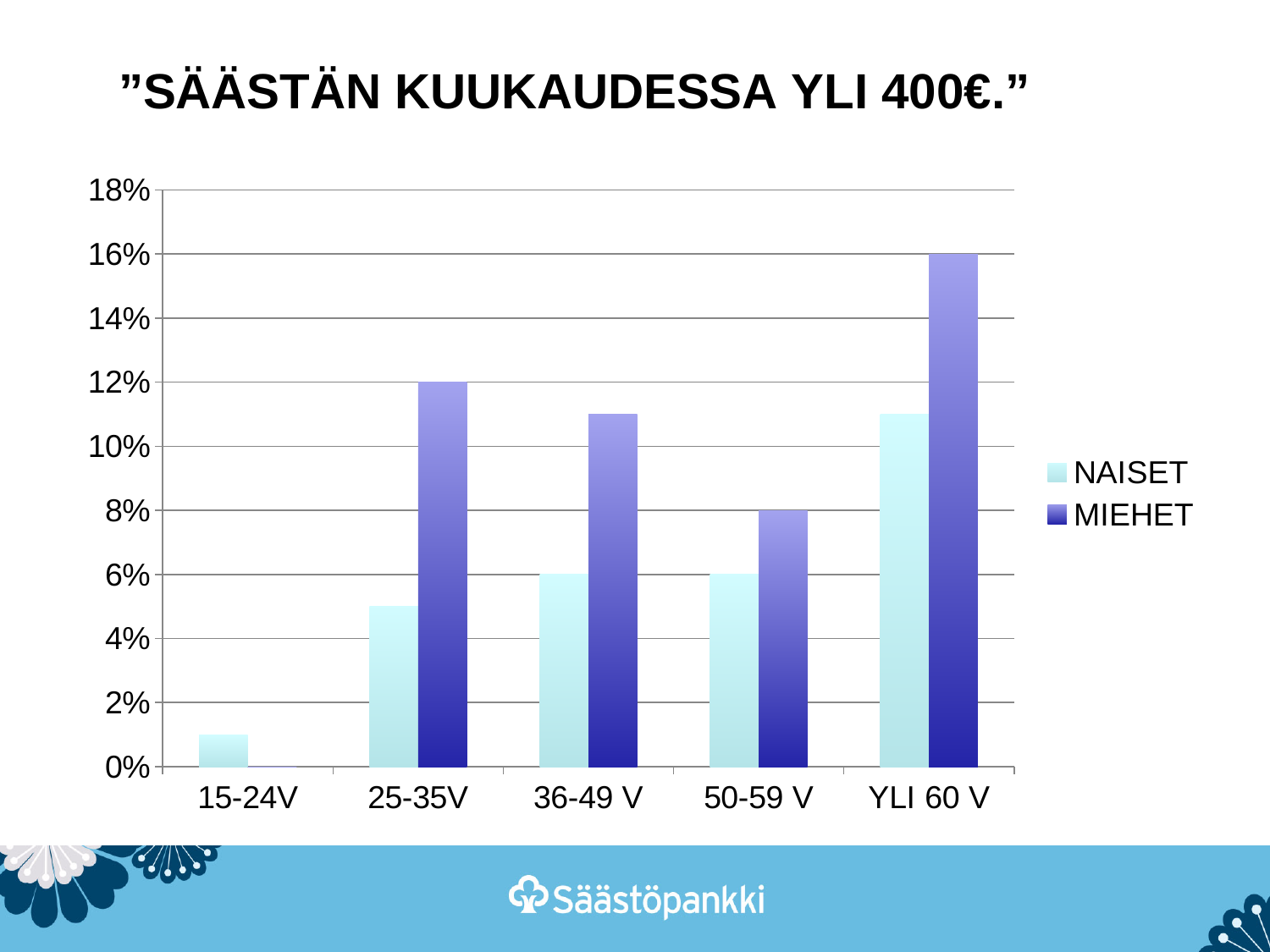
What is the difference between the MIEHET values for YLI 60 V and 25-35V? 4% Which age category has the highest MIEHET value? YLI 60 V What is the value for MIEHET in the YLI 60 V category? 16% Is the NAISET value for YLI 60 V greater or less than 10%? greater In the 25-35V category, which series has the larger value, NAISET or MIEHET? MIEHET Which age category has the lowest NAISET value? 15-24V What is the value for MIEHET in the 50-59 V category? 8% How many series does the legend list? 2 What kind of chart is shown on the slide? bar chart What is the value for NAISET in the 36-49 V category? 6% What is the value for MIEHET in the 25-35V category? 12% How many age categories are shown on the x axis? 5